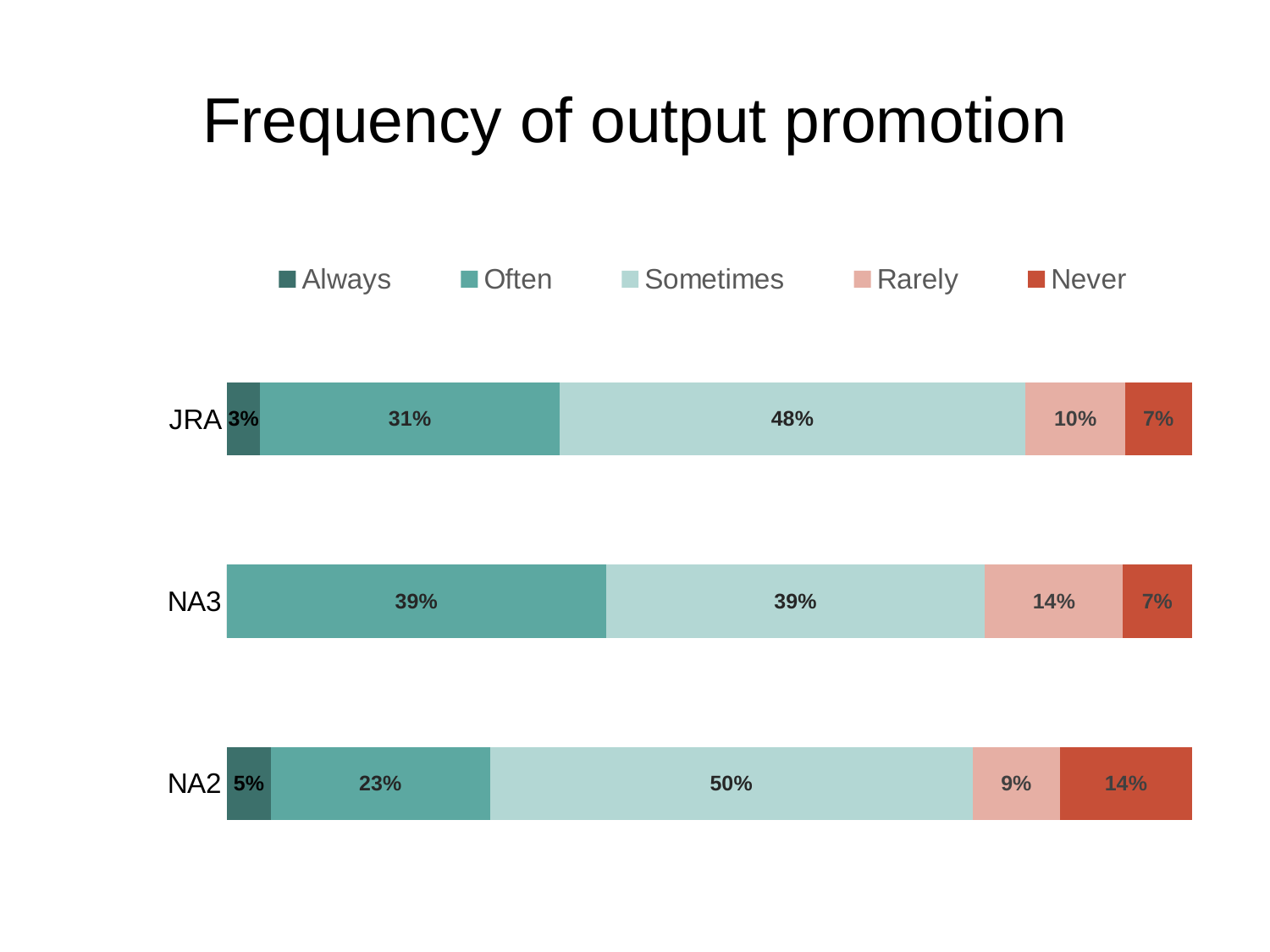
What is the Always value for NA2? 5% Which category has the lowest Often value? NA2 What is the Sometimes value for JRA? 48% What is the difference between the Often values for NA3 and JRA? 8% What is the Never value for NA2? 14% How many categories are shown on the chart? 3 Which is larger, the Rarely value for NA3 or the Rarely value for JRA? NA3 What is the title of the chart? Frequency of output promotion What is the Often value for NA3? 39% How many series does the legend list? 5 What kind of chart is shown on the slide? Stacked bar chart Which category has the highest Sometimes value? NA2